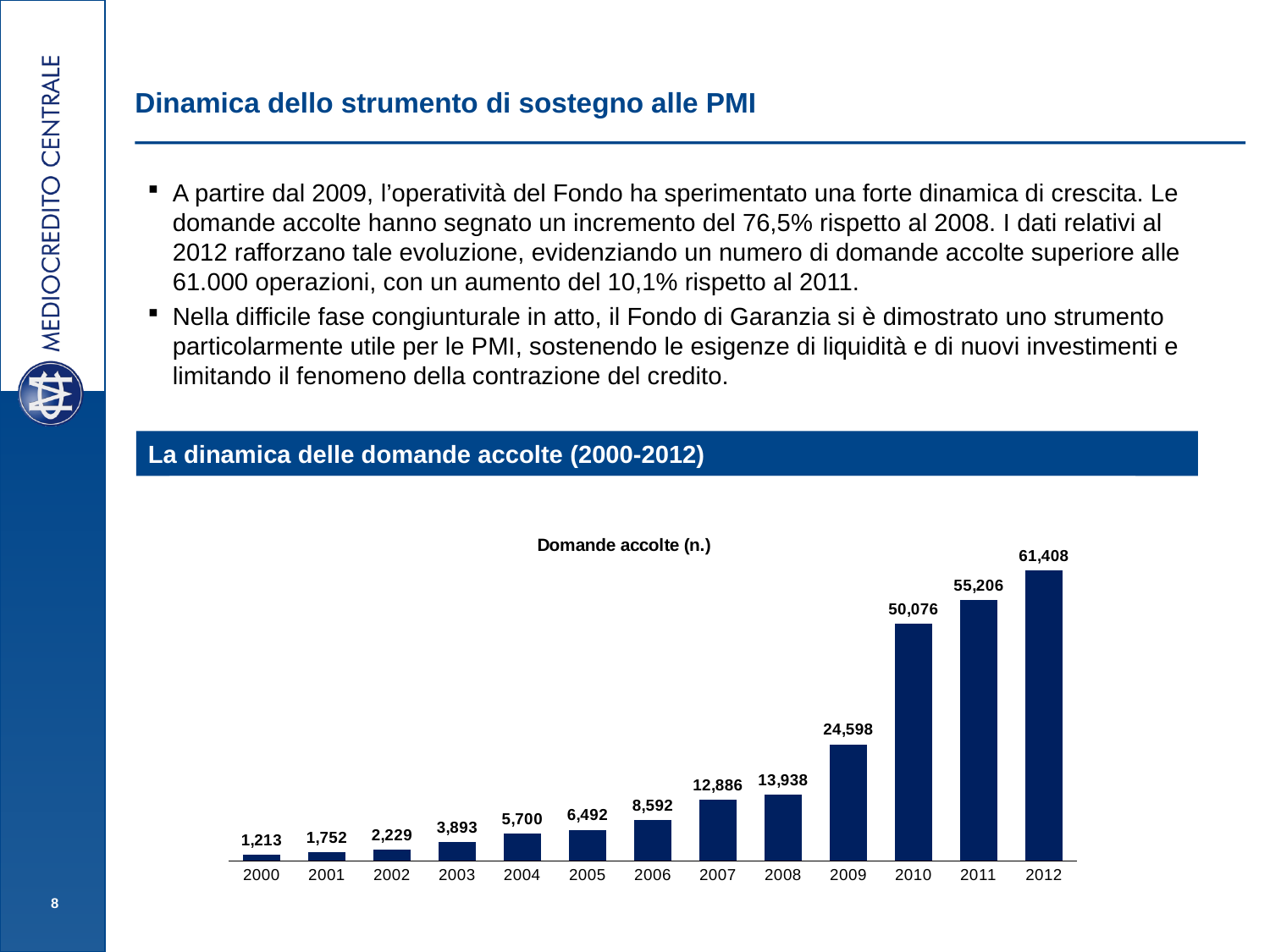
What is the title of the chart? Domande accolte (n.) Which is larger, the value for 2007 or the value for 2008? 2008 What is the difference between the values for 2009 and 2008? 10,660 Which year has the highest value in the chart? 2012 How many years are shown on the x axis of the chart? 13 What is the difference between the values for 2012 and 2011? 6,202 What is the value for 2009 in the chart? 24,598 What kind of chart is shown on the slide? bar chart What is the value for 2004 in the chart? 5,700 Do the values rise or fall from 2000 to 2012? rise Which year has the lowest value in the chart? 2000 What is the value for 2012 in the chart? 61,408